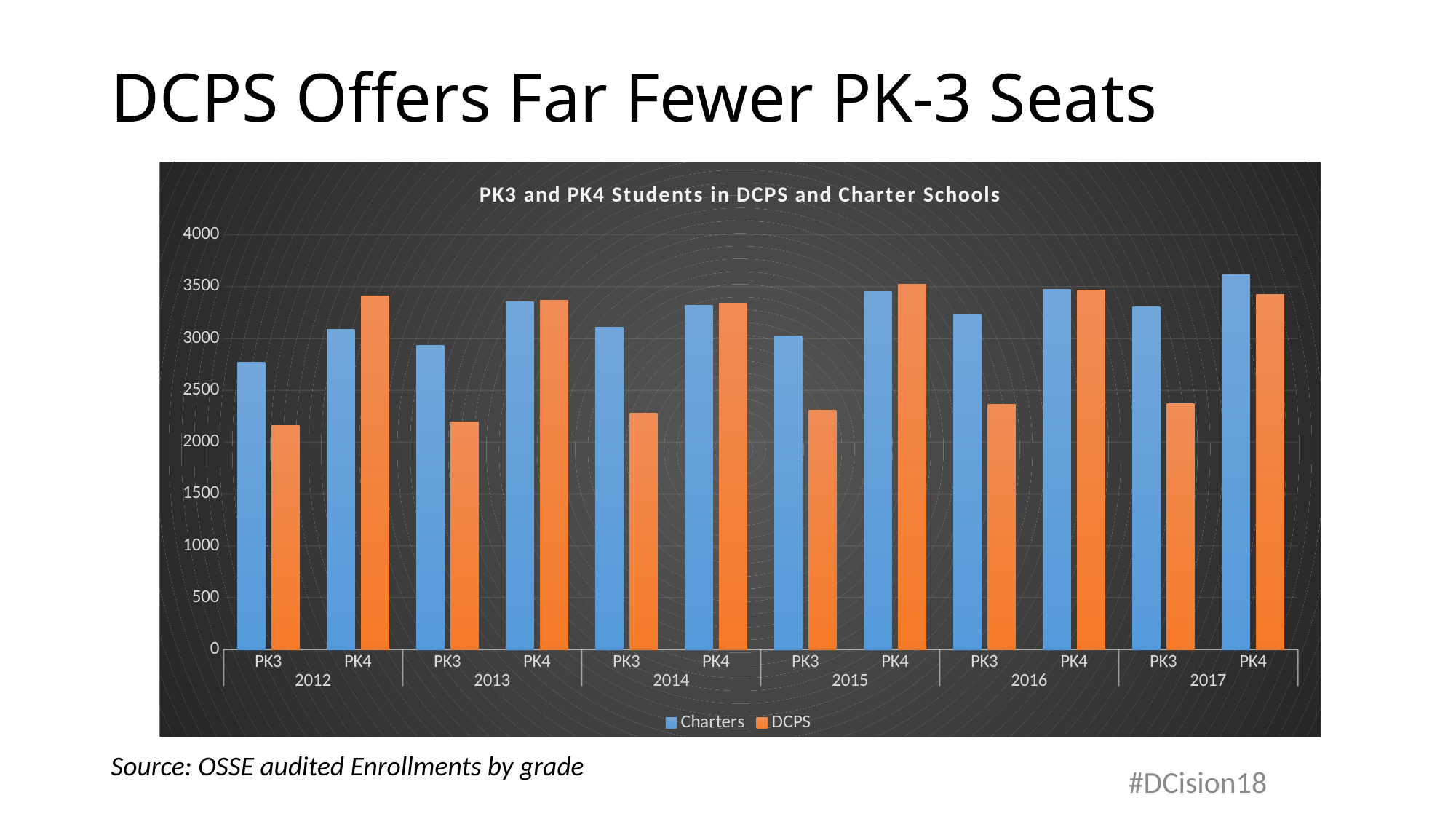
What is the title of the chart? PK3 and PK4 Students in DCPS and Charter Schools For PK4 in 2012, which is larger, Charters or DCPS? DCPS What kind of chart is shown on the slide? bar chart How many years are shown along the x axis? 6 How many series does the legend list? 2 For PK3 in 2015, which is larger, Charters or DCPS? Charters What are the two series named in the legend? Charters and DCPS Which bar is the lowest in the chart? DCPS, PK3 2012 Is the DCPS value for PK3 in 2012 greater or less than 2500? less Is the Charters value for PK4 in 2017 greater or less than 3500? greater Is the Charters value for PK3 in 2012 greater or less than 3000? less